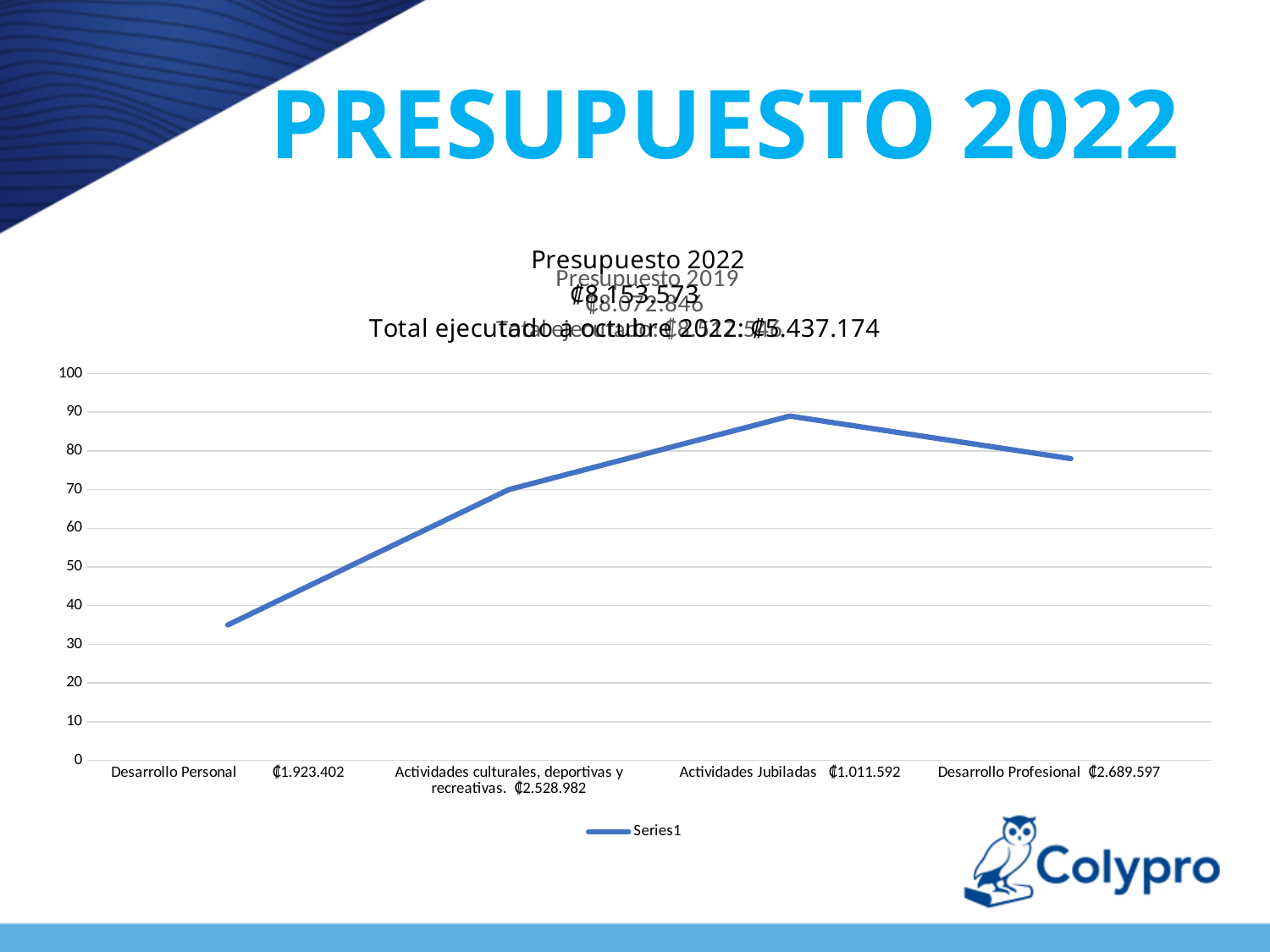
Is the value for Desarrollo Profesional greater or less than 80? less Does the line rise or fall between Actividades Jubiladas and Desarrollo Profesional? fall Which category has the highest value? Actividades Jubiladas Which category has the lowest value? Desarrollo Personal What kind of chart is shown on the slide? line chart How many series does the legend list? 1 Is the value for Actividades Jubiladas greater or less than 80? greater How many categories are plotted along the x axis? 4 Is the value for Desarrollo Personal greater or less than 40? less What is the name of the series shown in the legend? Series1 Which is larger, the value for Desarrollo Profesional or the value for Desarrollo Personal? Desarrollo Profesional